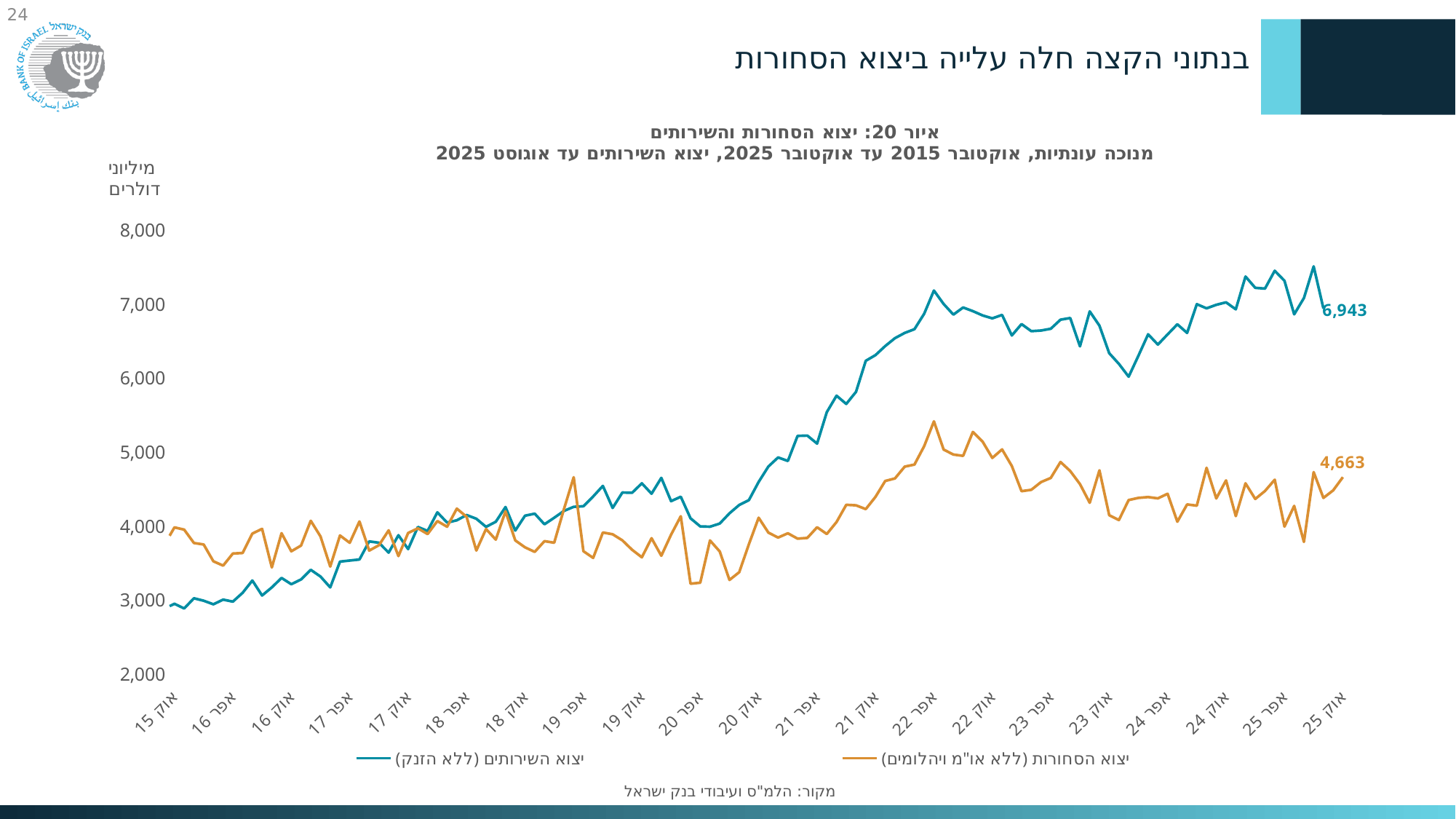
What is the difference between the two labelled end values, 6,943 and 4,663? 2,280 Is the labelled end value of the goods exports series greater or less than 5,000? less Is the labelled end value of the services exports series greater or less than 6,000? greater How many series does the legend list? 2 What type of chart is shown on the slide? line chart Overall, does the services exports series rise or fall from Oct 15 to Oct 25? rise What colour is the line for goods exports (יצוא הסחורות)? orange Is the services exports series at the start of the chart (Oct 15) greater or less than 4,000? less What is the last labelled value of the services exports series (יצוא השירותים (ללא הזנק))? 6,943 What unit is shown on the y axis? מיליוני דולרים Which series has the higher labelled end value, services exports or goods exports? services exports (יצוא השירותים (ללא הזנק)) What is the last labelled value of the goods exports series (יצוא הסחורות (ללא או"מ ויהלומים))? 4,663